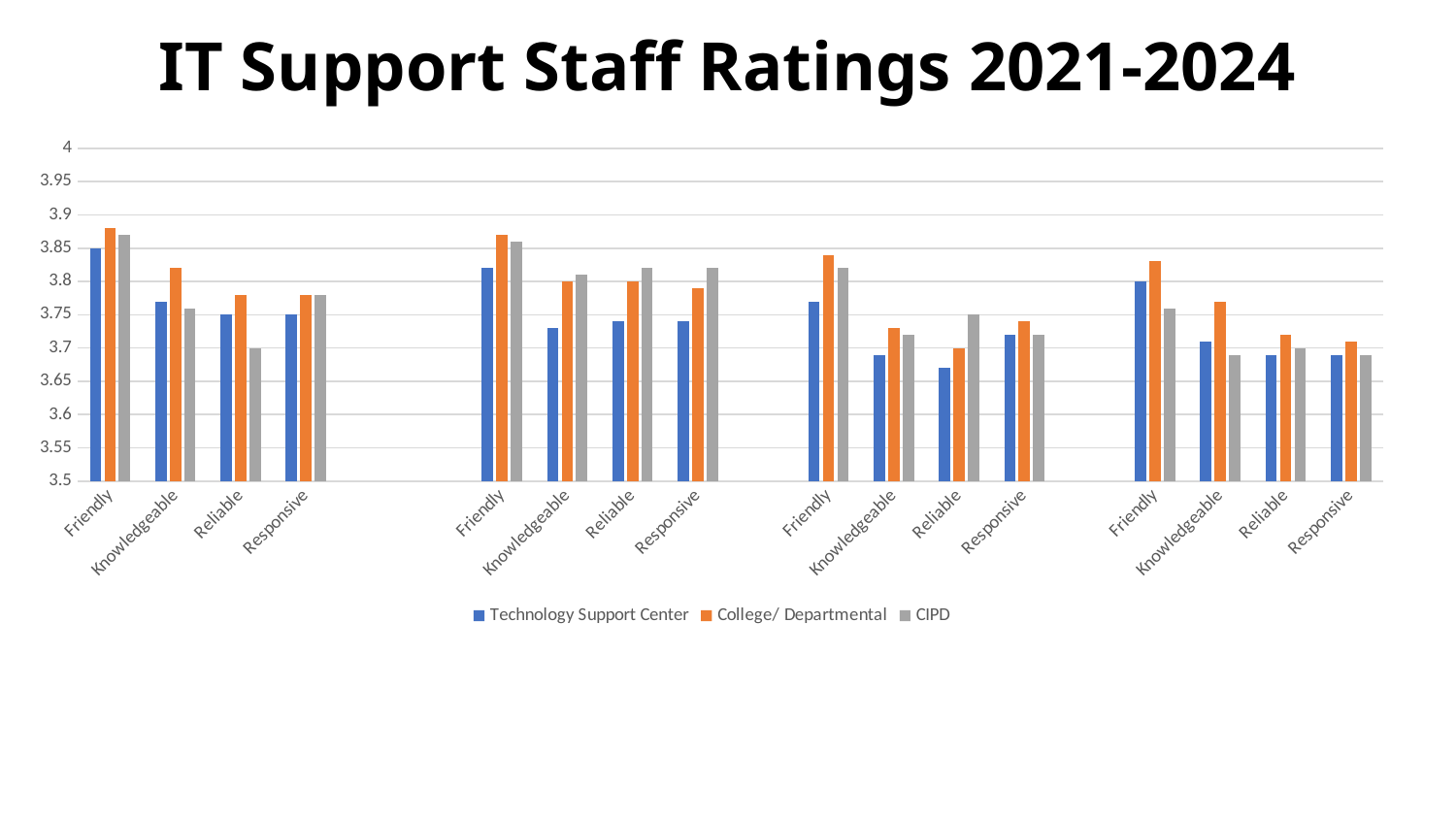
In the third group from the left, which is larger for Reliable: CIPD or Technology Support Center? CIPD In the first (leftmost) group, which series has the highest Friendly rating? College/ Departmental Which colour represents CIPD in the legend? gray What kind of chart is shown on the slide? bar chart In the third group from the left, which bar is the lowest? Technology Support Center, Reliable In the fourth (rightmost) group, do the College/ Departmental values rise or fall from Friendly to Responsive? fall In the third group from the left, is the Technology Support Center value for Reliable greater or less than 3.7? less In the first (leftmost) group, is the College/ Departmental value for Friendly greater or less than 3.85? greater What is the title of the chart? IT Support Staff Ratings 2021-2024 In the fourth (rightmost) group, is the College/ Departmental value for Friendly greater or less than 3.8? greater How many series does the legend list? 3 How many category labels appear along the x axis in total? 16